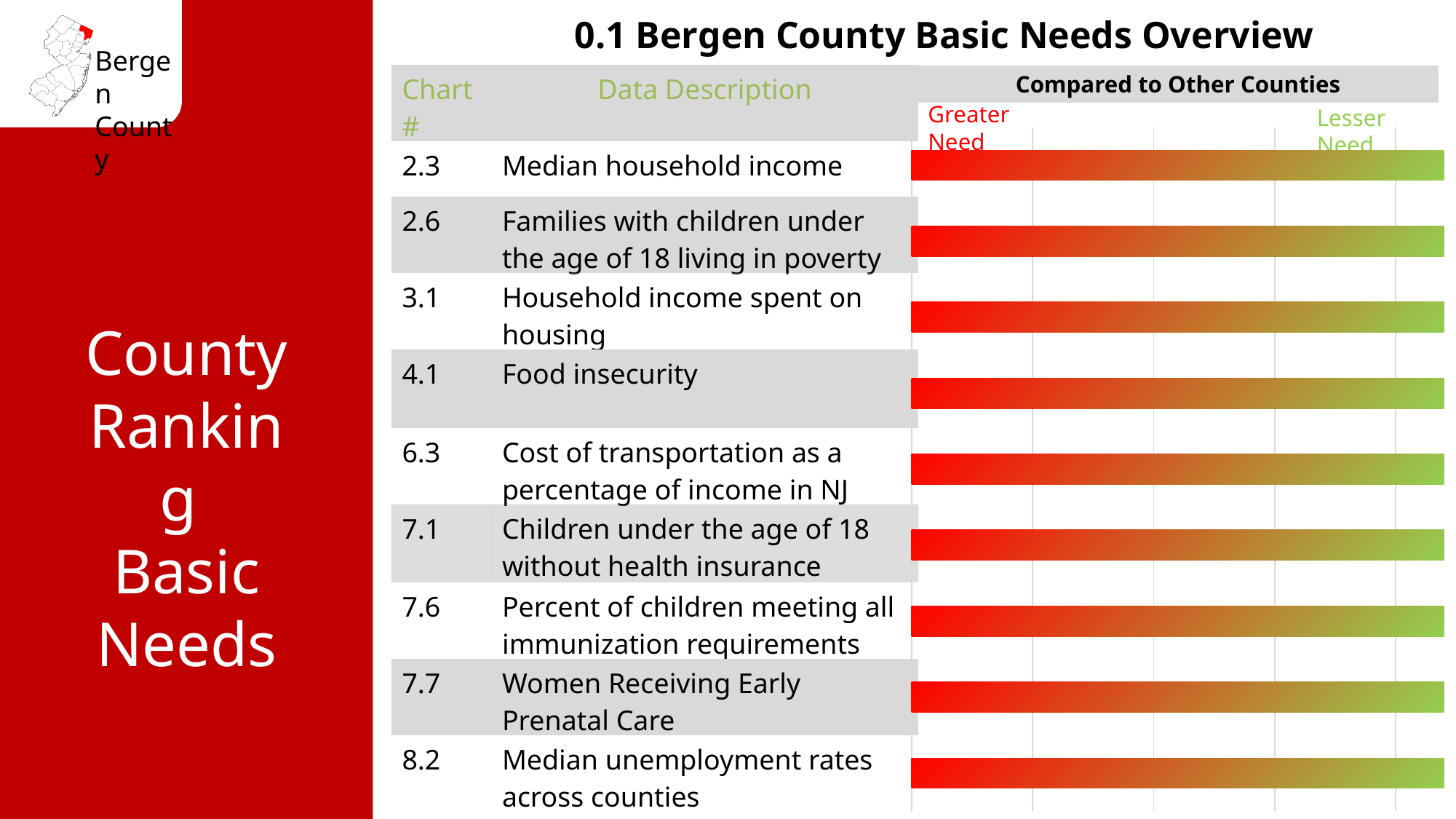
What label appears at the left end of the bar scale, and what label appears at the right end? Greater Need; Lesser Need What is the title of the chart? 0.1 Bergen County Basic Needs Overview Which data description is listed for chart number 7.7? Women Receiving Early Prenatal Care How many data description rows (bars) are shown in the chart? 9 Which chart number is listed for Median household income? 2.3 Which chart number is listed for Food insecurity? 4.1 Which data description is listed for chart number 8.2? Median unemployment rates across counties What kind of chart is shown on the slide? bar chart